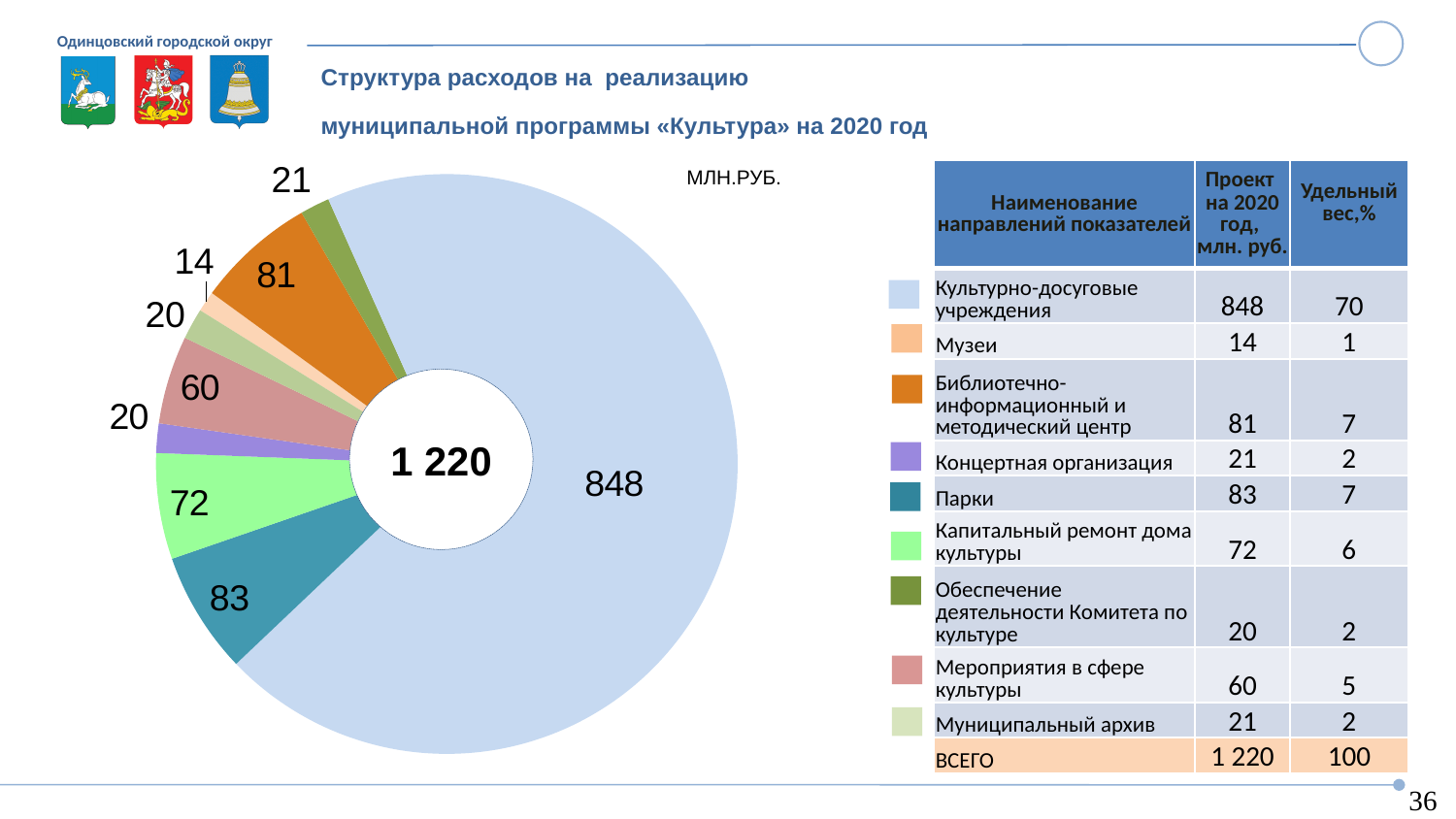
What is the value for Мероприятия в сфере культуры in the pie chart? 60 How many slices does the pie chart have? 9 What is the difference between the values for Парки and Капитальный ремонт дома культуры? 11 Which is larger: the value for Библиотечно-информационный и методический центр or the value for Мероприятия в сфере культуры? Библиотечно-информационный и методический центр What is the value shown for the largest slice of the pie chart? 848 Which category has the smallest slice in the pie chart? Музеи What unit is indicated for the values in the pie chart? МЛН.РУБ. What is the value for Парки in the pie chart? 83 What type of chart is shown on the slide? Pie (doughnut) chart What is the total shown in the centre of the doughnut chart? 1 220 Which category has the largest slice in the pie chart? Культурно-досуговые учреждения What is the value for Капитальный ремонт дома культуры in the pie chart? 72